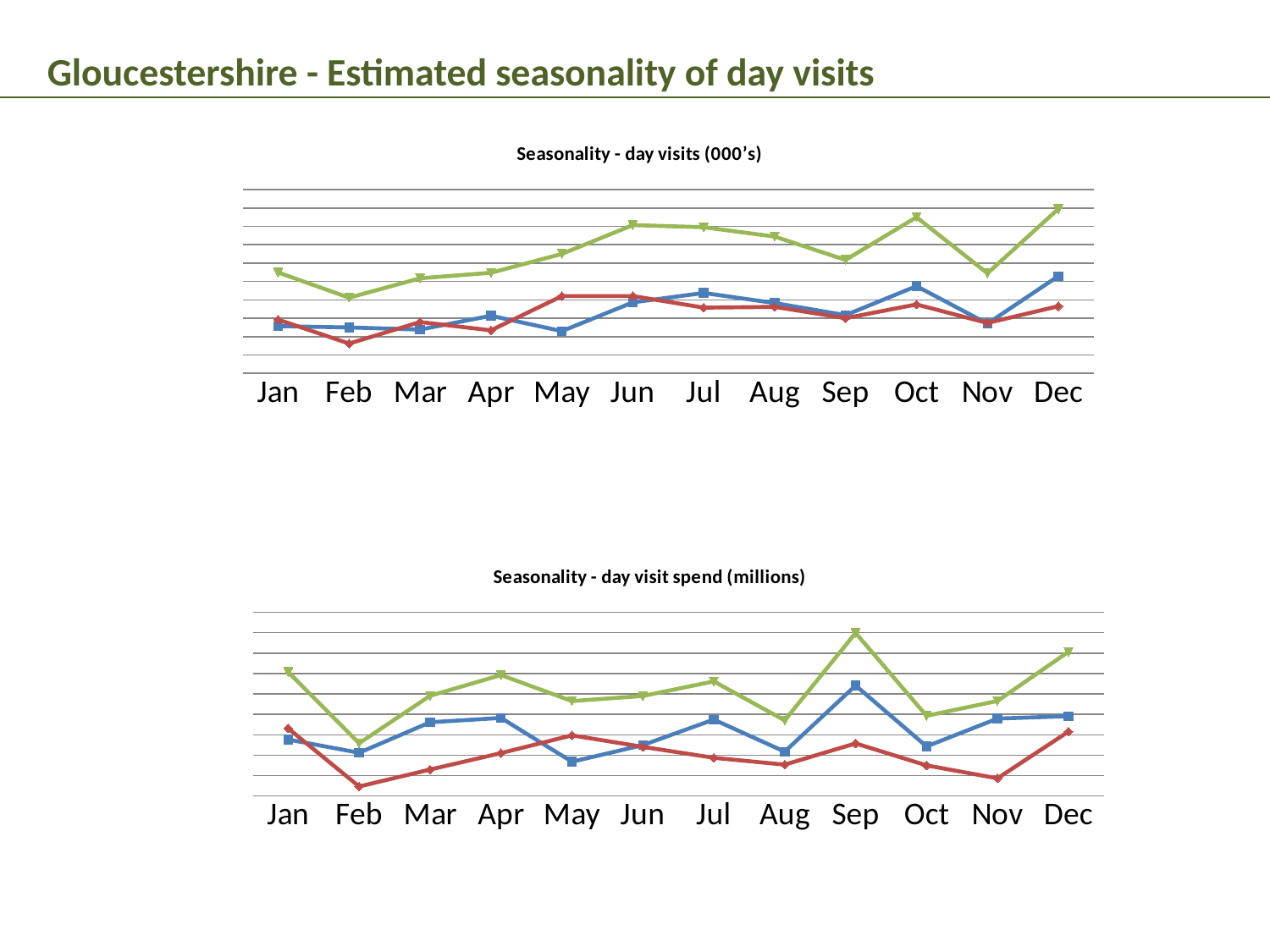
What is the title of the bottom chart? Seasonality - day visit spend (millions) In the bottom chart, how many lines are plotted? 3 What kind of chart is the top chart titled "Seasonality - day visits (000's)"? Line chart In the top chart, which line is higher in Jun, the green line or the blue line? Green line In the top chart, in which month is the red line at its lowest? Feb In the top chart, in which month is the green line at its lowest? Feb In the top chart, how many months are shown on the x axis? 12 In the bottom chart, in which month does the green line reach its highest point? Sep In the bottom chart, in which month does the blue line reach its highest point? Sep In the bottom chart, in which month is the red line at its lowest? Feb What kind of chart is the bottom chart titled "Seasonality - day visit spend (millions)"? Line chart In the top chart, in which month does the green line reach its highest point? Dec